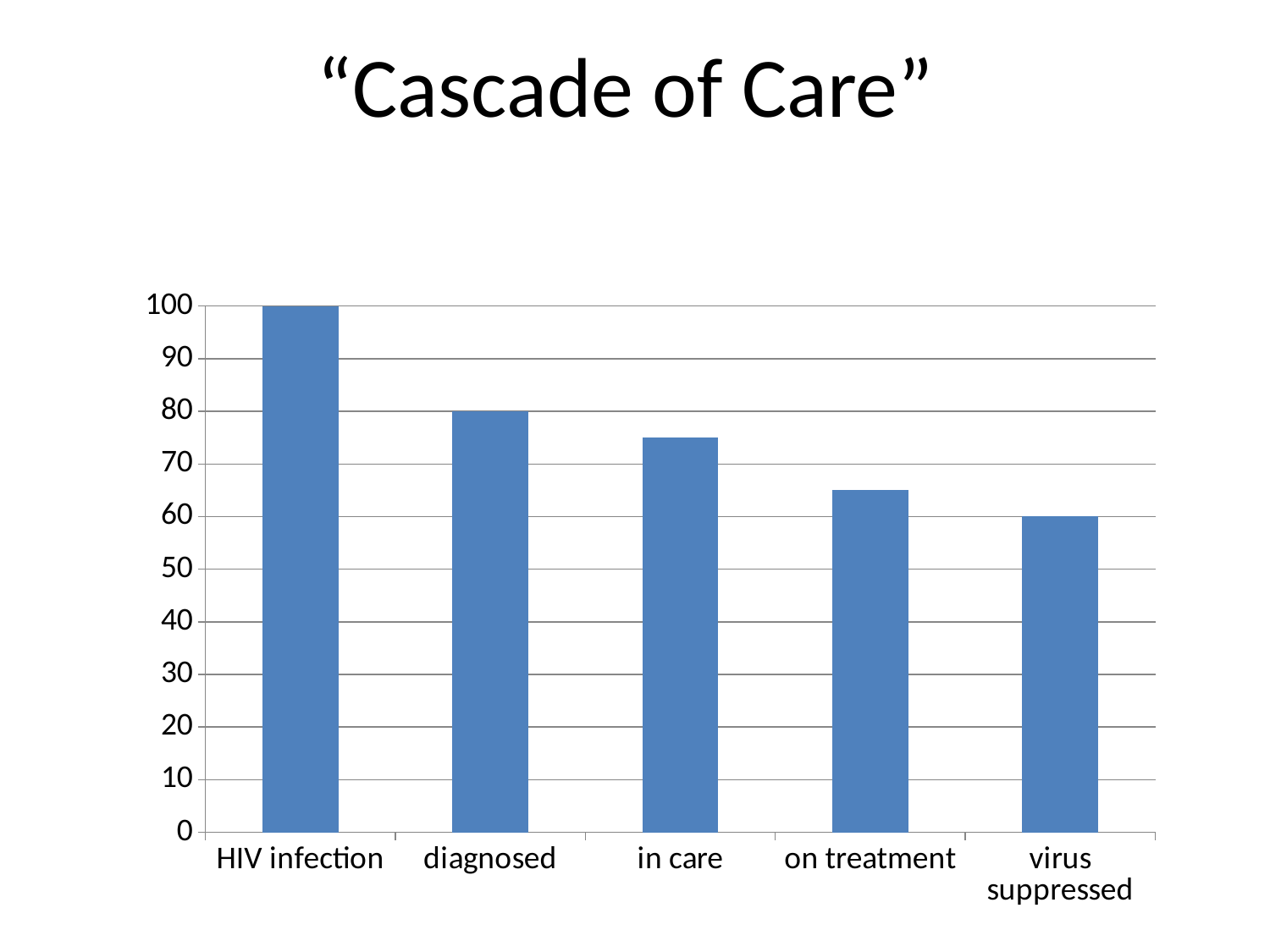
What is the difference between the values for HIV infection and diagnosed? 20 Which category has the highest value? HIV infection Is the value for in care greater or less than 70? greater What kind of chart is shown on the slide? bar chart Is the value for on treatment greater or less than 70? less Which category has the lowest value? virus suppressed How many categories are shown on the x axis? 5 What is the value for HIV infection? 100 Which is larger, the value for in care or the value for on treatment? in care What is the value for diagnosed? 80 What is the difference between the values for HIV infection and virus suppressed? 40 What is the value for virus suppressed? 60